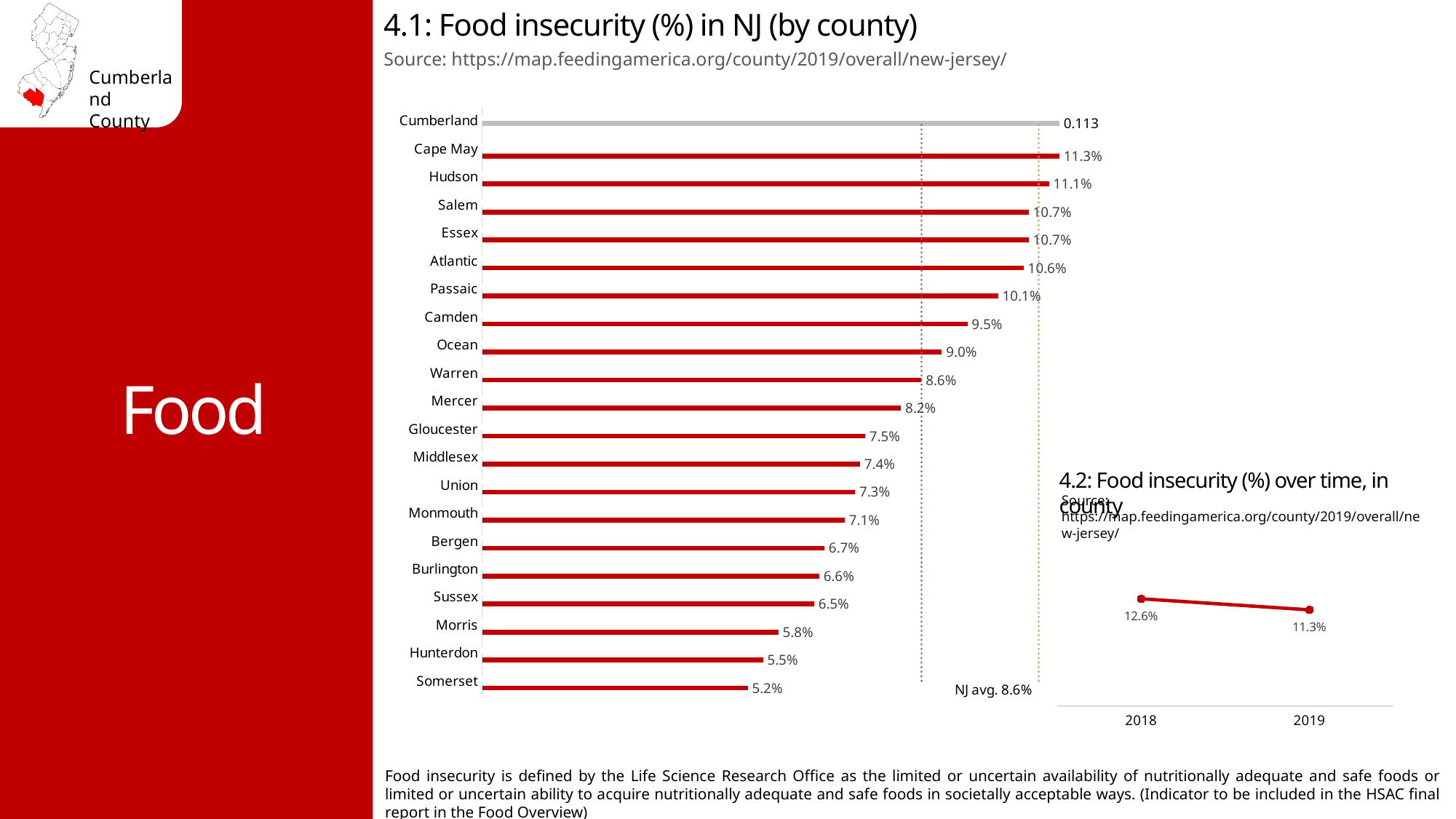
In chart 4.1 (Food insecurity by county), how many counties are listed? 21 In chart 4.2 (Food insecurity over time), does the value rise or fall from 2018 to 2019? Fall In chart 4.1 (Food insecurity by county), what label is printed next to the Cumberland bar? 0.113 In chart 4.1 (Food insecurity by county), what is the difference between Hudson and Salem? 0.4 percentage points In chart 4.1 (Food insecurity by county), what NJ average value is labelled on the chart? 8.6% In chart 4.2 (Food insecurity over time), what is the value for 2018? 12.6% In chart 4.1 (Food insecurity by county), which county has the lowest value? Somerset What kind of chart is chart 4.1 (Food insecurity by county)? Bar chart In chart 4.2 (Food insecurity over time), what is the difference between the 2018 and 2019 values? 1.3 percentage points In chart 4.1 (Food insecurity by county), which is larger, Camden or Ocean? Camden In chart 4.1 (Food insecurity by county), what is the value shown for Somerset? 5.2% In chart 4.1 (Food insecurity by county), what is the value shown for Cape May? 11.3%